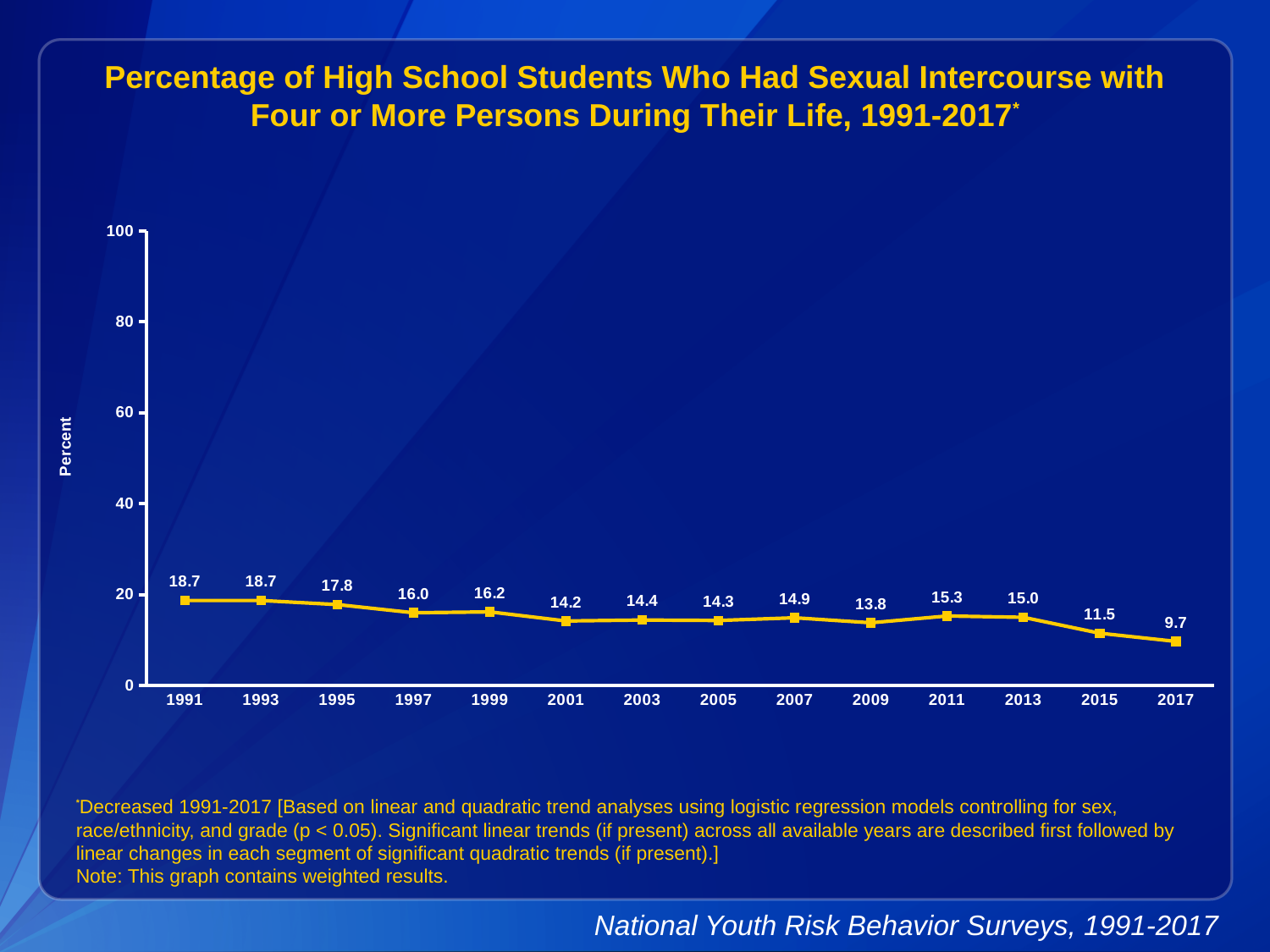
Which year has the lowest value? 2017 What is the value for 2011? 15.3 Do the values generally rise or fall from 1991 to 2017? fall Which is larger, the value for 2009 or the value for 2011? 2011 What kind of chart is shown? line chart How many years are plotted on the chart? 14 What is the value for 2001? 14.2 What is the difference between the values for 2013 and 2015? 3.5 What is the difference between the values for 1991 and 2017? 9.0 Is the value for 1995 greater or less than 20? less What is the value for 2017? 9.7 What is the label on the y axis? Percent